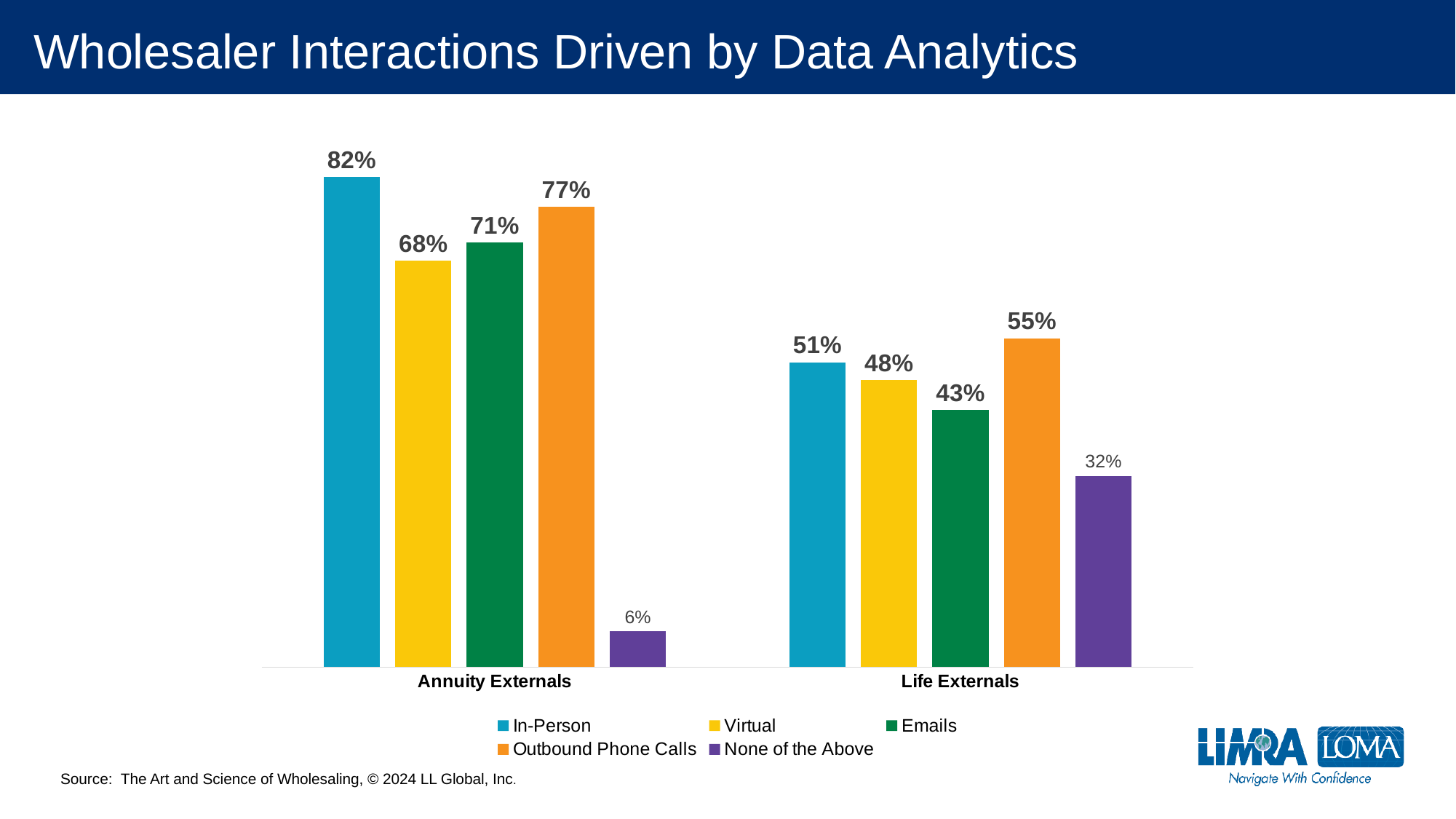
What is the value for Outbound Phone Calls among Life Externals? 55% Which is larger for Life Externals: Virtual or Outbound Phone Calls? Outbound Phone Calls What is the difference between the Emails values for Annuity Externals and Life Externals? 28% What is the title of the slide? Wholesaler Interactions Driven by Data Analytics How many categories are shown on the x axis? 2 What is the value for In-Person among Annuity Externals? 82% What colour are the Outbound Phone Calls bars? Orange What kind of chart is shown on the slide? Bar chart Which series has the highest value for Annuity Externals? In-Person What is the value for None of the Above among Life Externals? 32% How many series does the legend list? 5 Which series has the lowest value for Life Externals? None of the Above